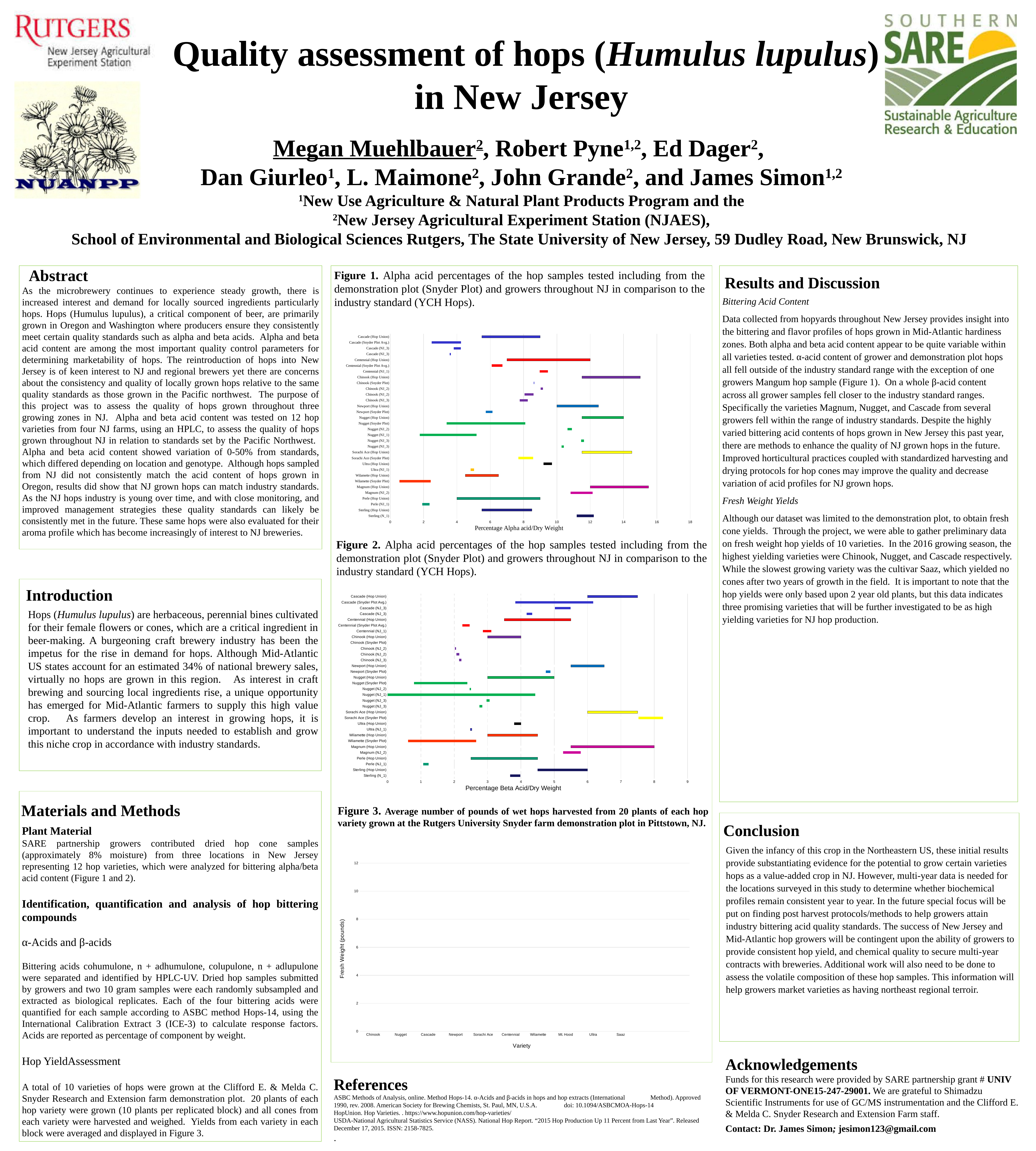
In Figure 2, what is the label on the horizontal axis? Percentage Beta Acid/Dry Weight In Figure 2, is the beta acid range for Magnum (Hop Union) greater or less than 5? greater In Figure 1, what is the label on the horizontal axis? Percentage Alpha acid/Dry Weight In Figure 2, is the beta acid value for Perle (NJ_1) greater or less than 2? less In Figure 3, how many hop varieties are listed along the x axis? 10 In Figure 1, is the alpha acid range for Cascade (Hop Union) greater or less than 4? greater In Figure 3, what is the label on the vertical axis? Fresh Weight (pounds)